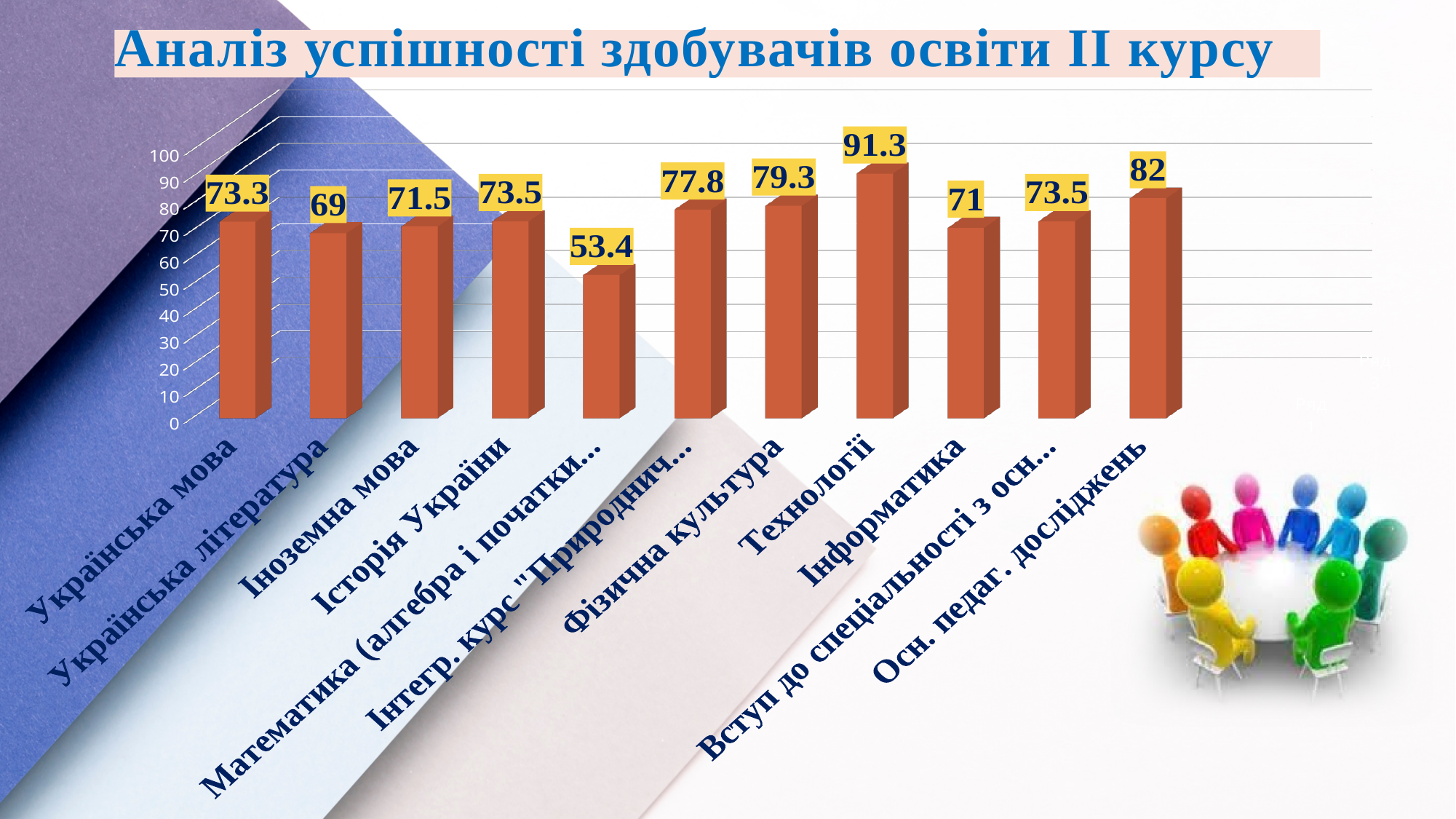
Which is larger, the value for Іноземна мова or the value for Інформатика? Іноземна мова What is the difference between the values for Осн. педаг. досліджень and Історія України? 8.5 What is the value for Технології? 91.3 What kind of chart is shown on the slide? Bar chart What is the value for Осн. педаг. досліджень? 82 Which category has the highest value? Технології Which category has the lowest value? Математика (алгебра і початки... How many bars are shown in the chart? 11 What is the title of the slide? Аналіз успішності здобувачів освіти ІІ курсу What is the value for Фізична культура? 79.3 What is the value for Українська мова? 73.3 What is the difference between the values for Технології and Українська література? 22.3